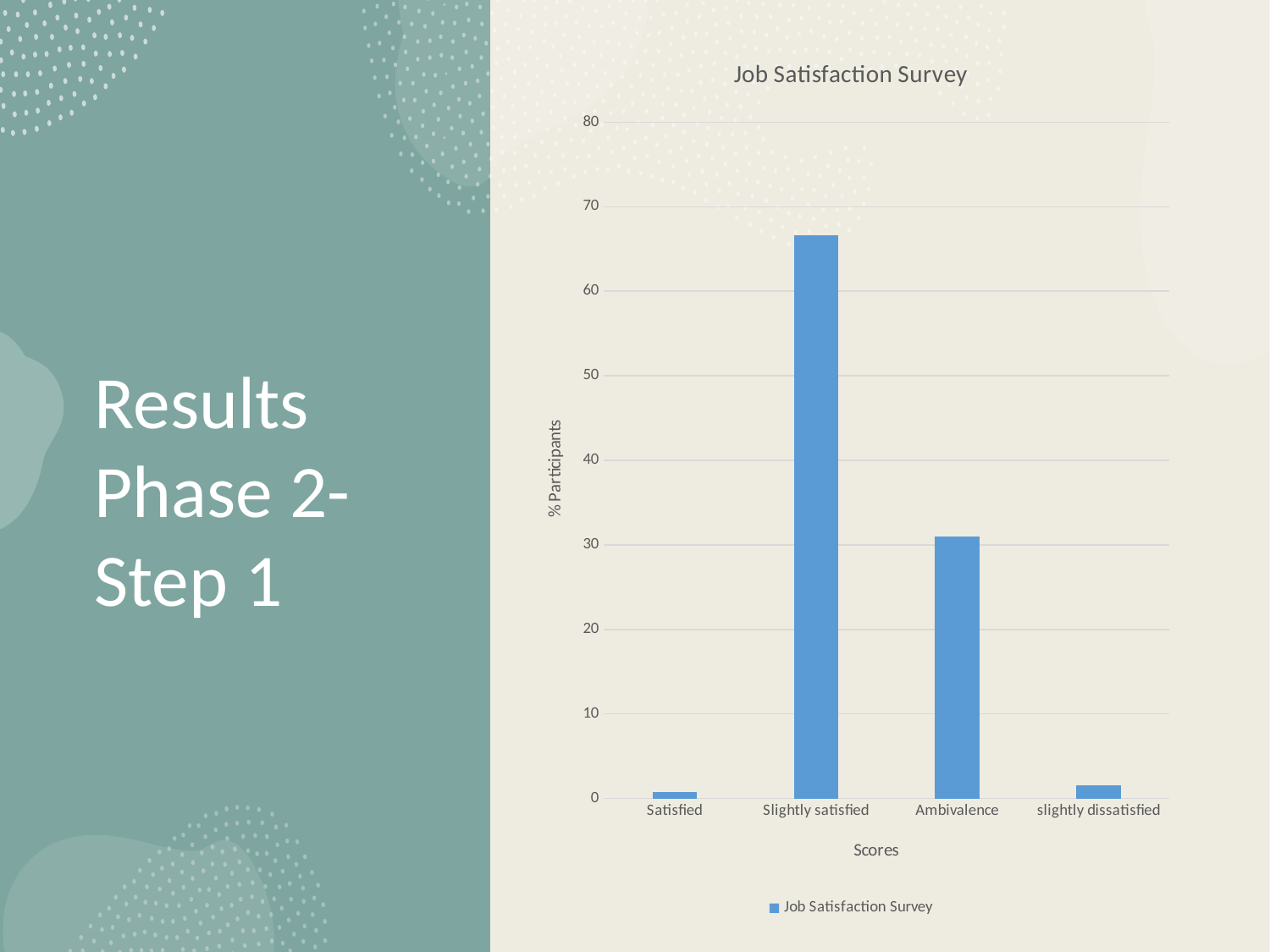
Which is larger, the value for Ambivalence or the value for Satisfied? Ambivalence How many series does the chart legend list? 1 Which category has the highest value in the chart? Slightly satisfied What is the label of the vertical axis of the chart? % Participants What is the title of the chart? Job Satisfaction Survey How many categories are shown on the x axis of the chart? 4 Is the value for slightly dissatisfied greater or less than 10? less Is the value for Slightly satisfied greater or less than 60? greater What type of chart is shown on the slide? bar chart Is the value for Slightly satisfied greater or less than 70? less Which is larger, the value for Slightly satisfied or the value for Ambivalence? Slightly satisfied